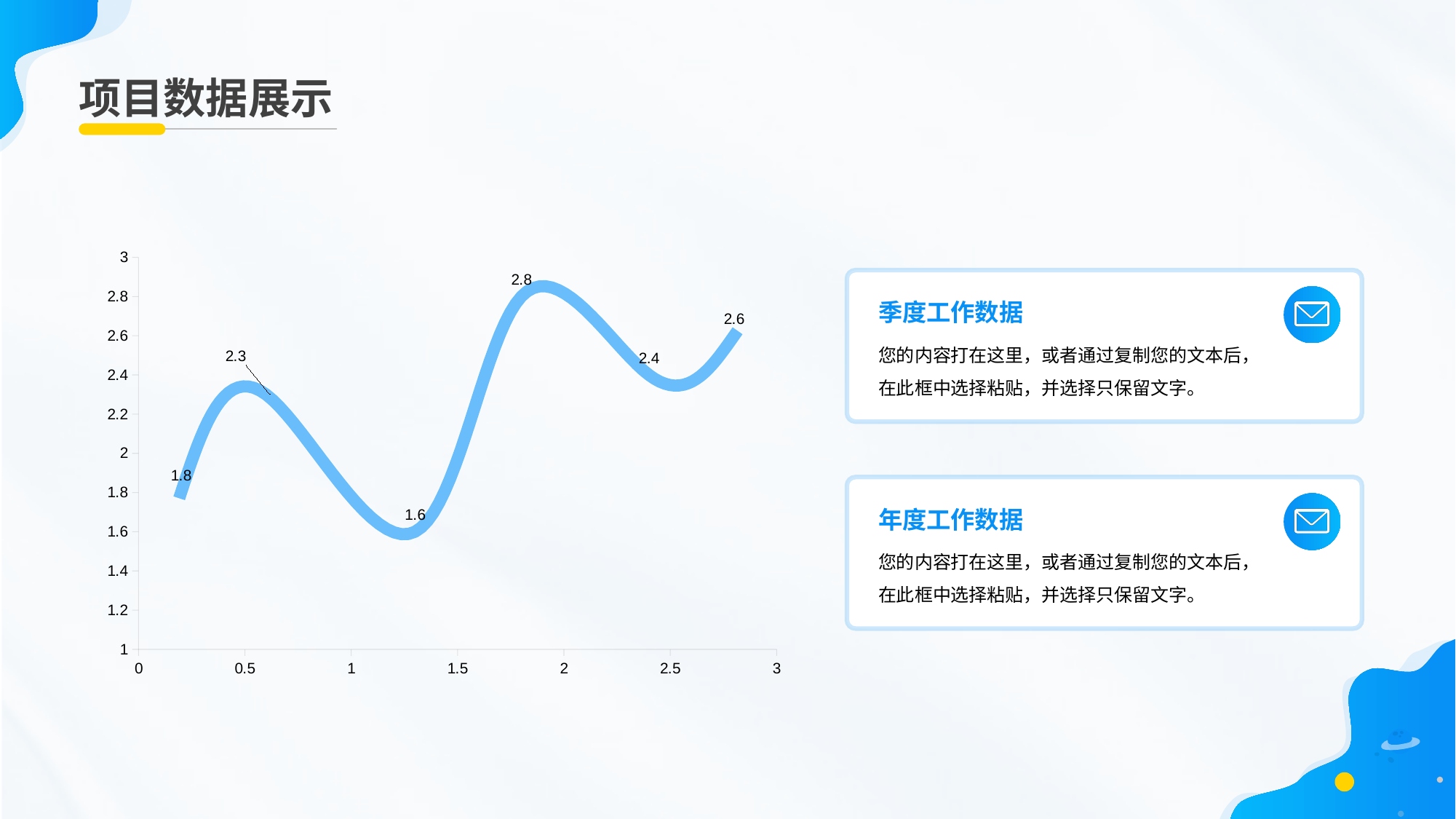
What is the value of the last (rightmost) data point on the line chart? 2.6 What is the maximum value shown on the vertical axis of the line chart? 3 How many data points are labelled on the line chart? 6 Is the value of the third data point on the line chart greater or less than 2? less What is the difference between the first data point (1.8) and the second data point (2.3) on the line chart? 0.5 What is the title of the slide containing the line chart? 项目数据展示 What is the value of the first (leftmost) data point on the line chart? 1.8 What kind of chart is shown on the slide? line chart What is the difference between the highest labelled value (2.8) and the lowest labelled value (1.6) on the line chart? 1.2 What is the highest labelled value on the line chart? 2.8 What is the lowest labelled value on the line chart? 1.6 Which is larger on the line chart: the second data point (2.3) or the fifth data point (2.4)? 2.4